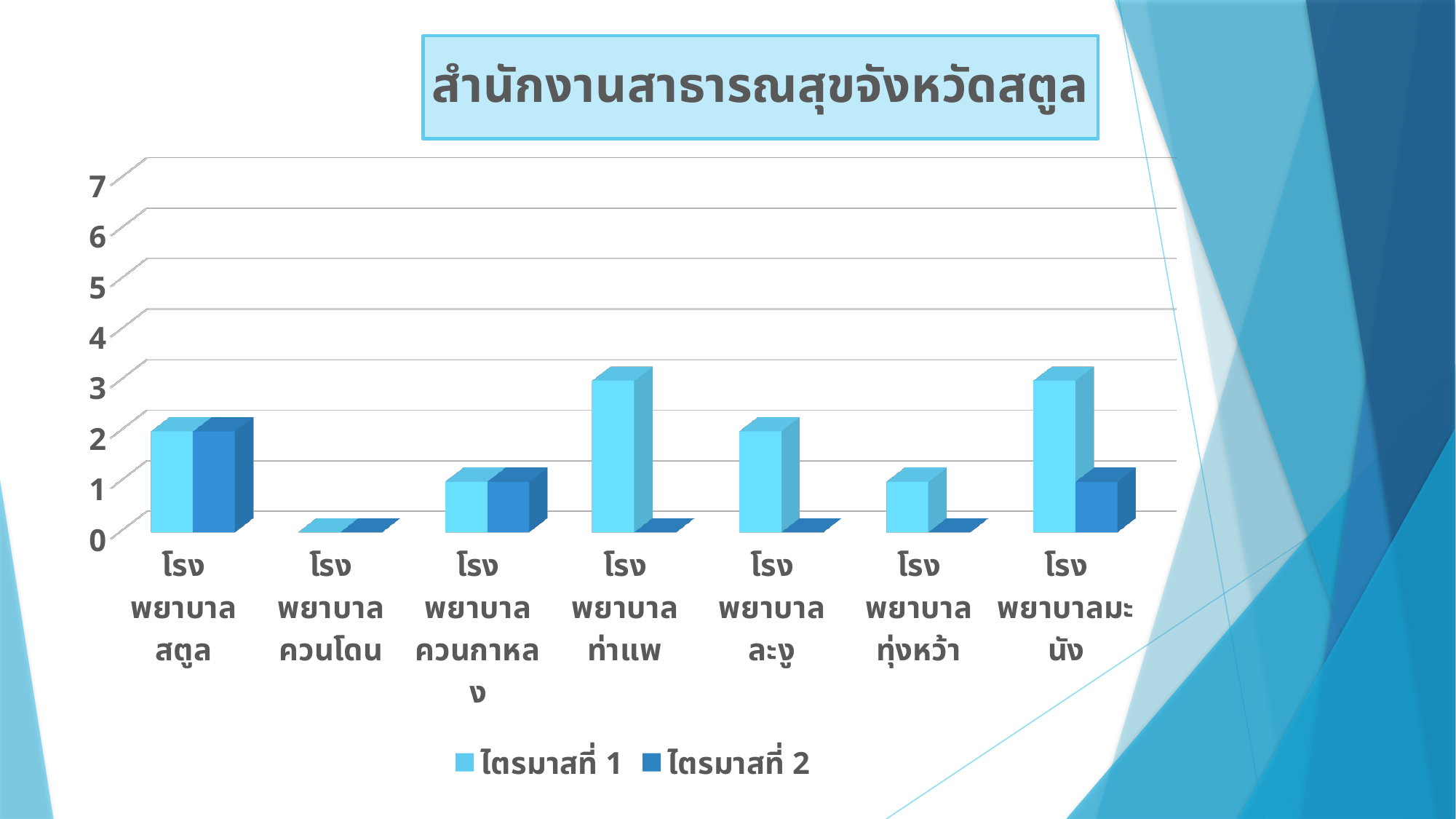
How many hospital categories are shown on the x axis? 7 Which hospital has the lowest value for ไตรมาสที่ 1? โรงพยาบาลควนโดน Which is larger for ไตรมาสที่ 1: โรงพยาบาลท่าแพ or โรงพยาบาลละงู? โรงพยาบาลท่าแพ What is the value for โรงพยาบาลควนโดน in ไตรมาสที่ 2? 0 Is the value for โรงพยาบาลท่าแพ in ไตรมาสที่ 1 greater or less than 2? greater Is the value for โรงพยาบาลทุ่งหว้า in ไตรมาสที่ 1 greater or less than 2? less Which is larger for ไตรมาสที่ 2: โรงพยาบาลสตูล or โรงพยาบาลมะนัง? โรงพยาบาลสตูล Which series is shown in the darker blue colour? ไตรมาสที่ 2 Which hospital has the highest value for ไตรมาสที่ 2? โรงพยาบาลสตูล What kind of chart is shown on the slide? bar chart What is the title of the chart? สำนักงานสาธารณสุขจังหวัดสตูล How many series does the legend list? 2